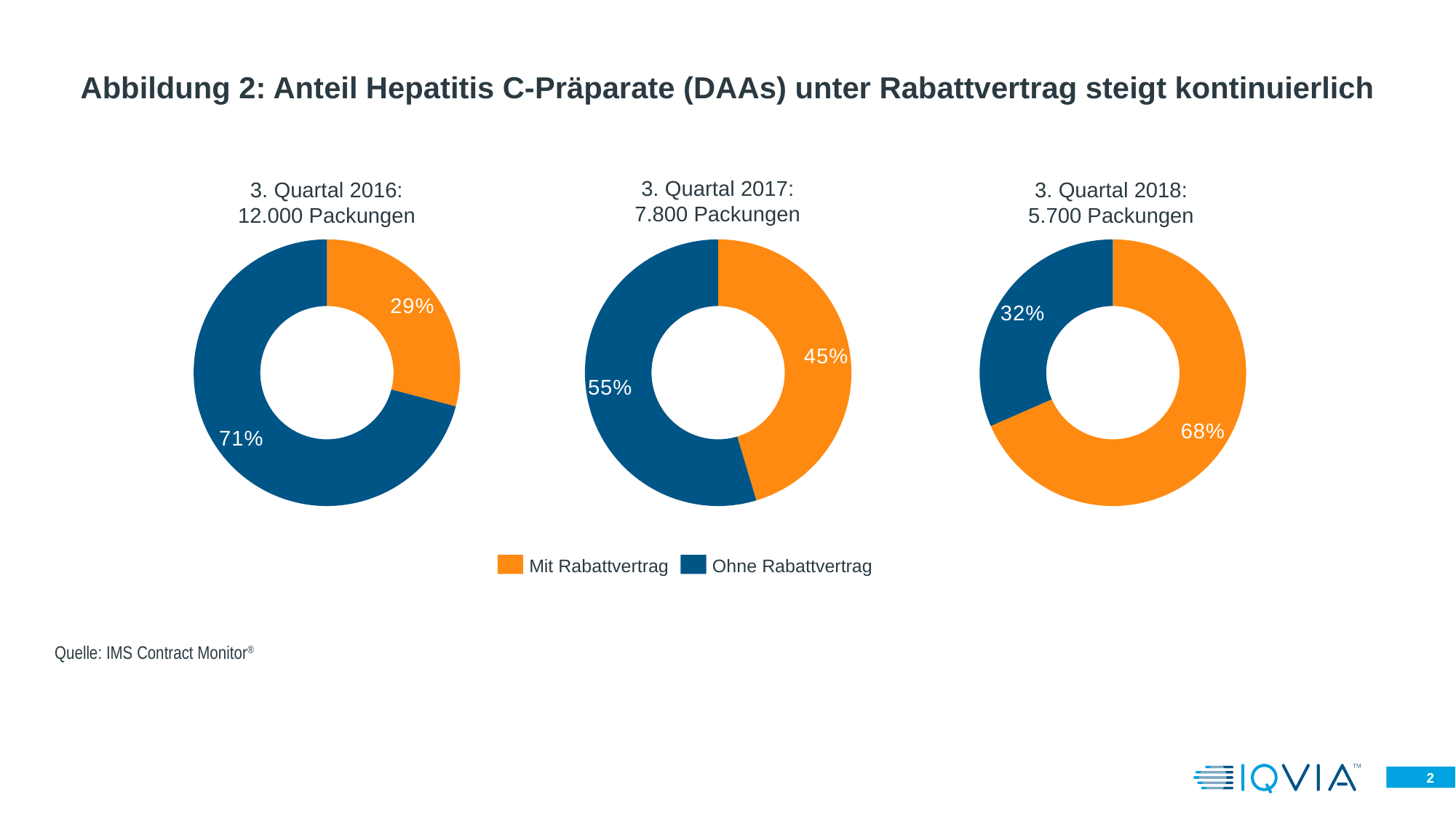
In the '3. Quartal 2017' chart, which slice is larger, 'Mit Rabattvertrag' or 'Ohne Rabattvertrag'? Ohne Rabattvertrag How many entries does the legend list? 2 In the '3. Quartal 2016' chart, what share is labelled for 'Ohne Rabattvertrag'? 71% In the '3. Quartal 2016' chart, which slice is the smallest? Mit Rabattvertrag In the '3. Quartal 2016' chart, what share is labelled for 'Mit Rabattvertrag'? 29% In the '3. Quartal 2018' chart, which slice is the largest? Mit Rabattvertrag In the '3. Quartal 2017' chart, what share is labelled for 'Mit Rabattvertrag'? 45% In the '3. Quartal 2018' chart, what share is labelled for 'Ohne Rabattvertrag'? 32% What kind of chart is used for '3. Quartal 2017'? Doughnut chart How many packages ('Packungen') are stated for the '3. Quartal 2017' chart? 7.800 Packungen What is the difference between the 'Mit Rabattvertrag' share in the '3. Quartal 2018' chart and in the '3. Quartal 2016' chart? 39% In the '3. Quartal 2018' chart, what share is labelled for 'Mit Rabattvertrag'? 68%